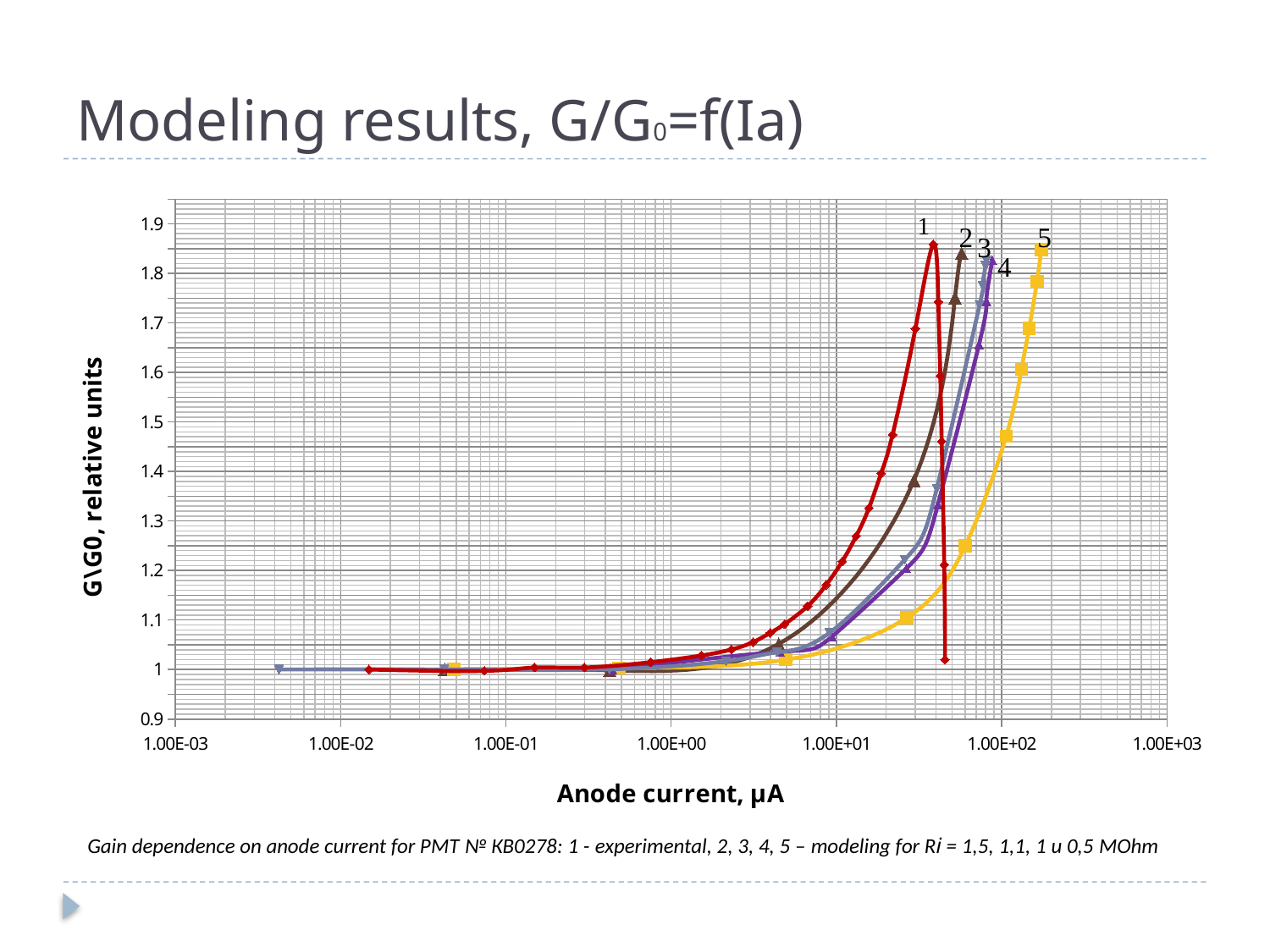
Do the curves rise or fall as anode current increases from 1.00E+00 to 1.00E+01 μA? rise Is the peak value of curve 5 greater or less than 1.8? greater Which curve reaches its peak at the lowest anode current? 1 Which curve reaches its peak at the highest anode current? 5 Is the value of curve 5 at 1.00E+02 μA greater or less than 1.4? greater What is the title of the x axis? Anode current, μA What kind of chart is shown on the slide? line chart What is the highest tick value shown on the y axis? 1.9 What is the title of the y axis? G\G0, relative units Is the peak value of curve 1 greater or less than 1.8? greater How many numbered curves are plotted on the chart? 5